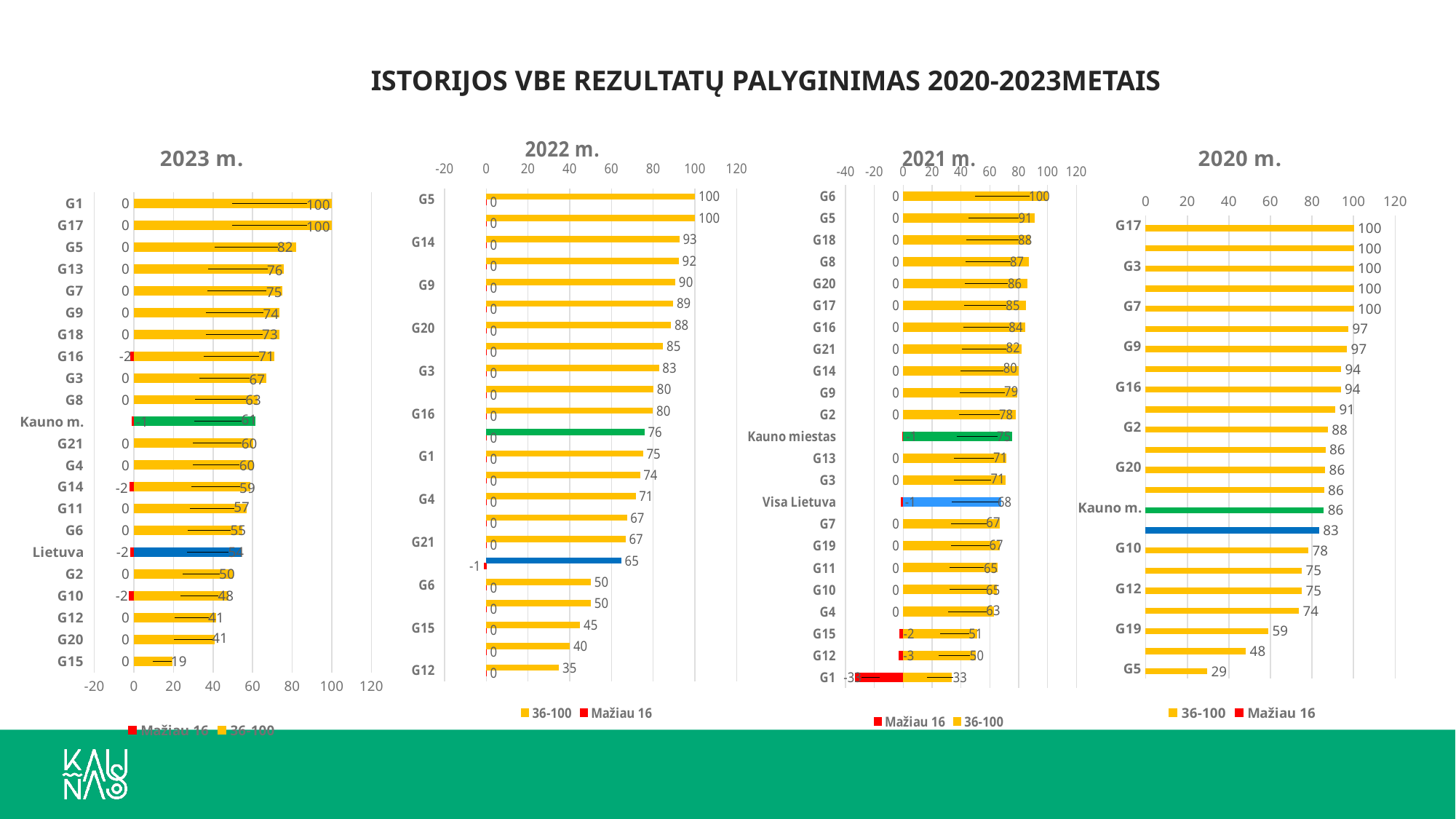
In the 2021 m. chart, which category has the lowest 36-100 value? G1 In the 2023 m. chart, what is the 36-100 value for G5? 82 In the 2021 m. chart, which has the larger 36-100 value, G5 or G4? G5 In the 2021 m. chart, what is the 36-100 value for G6? 100 How many series does the legend of the 2020 m. chart list? 2 In the 2023 m. chart, what is the Mažiau 16 value for G10? -2 In the 2023 m. chart, what is the difference between the 36-100 values for G1 and G15? 81 In the 2020 m. chart, what is the value for G5? 29 In the 2022 m. chart, what is the 36-100 value for G12? 35 In the 2023 m. chart, which category has the lowest 36-100 value? G15 How many categories are shown in the 2023 m. chart? 22 In the 2021 m. chart, what is the 36-100 value for Visa Lietuva? 68